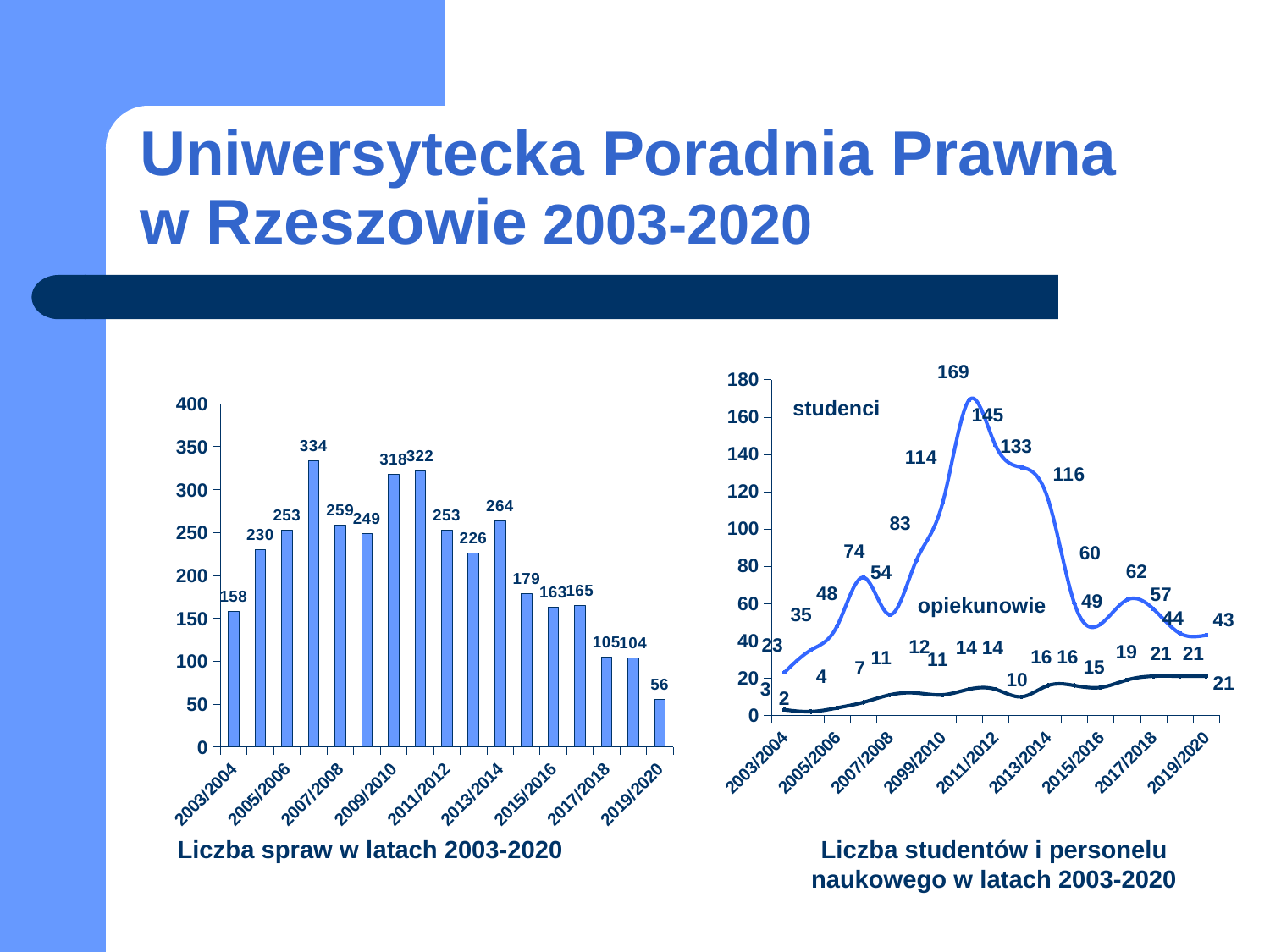
In the chart 'Liczba spraw w latach 2003-2020', which is larger: the value for 2009/2010 or the value for 2011/2012? 2009/2010 In the chart 'Liczba spraw w latach 2003-2020', what is the value for 2019/2020? 56 What kind of chart is 'Liczba studentów i personelu naukowego w latach 2003-2020'? line chart In the chart 'Liczba spraw w latach 2003-2020', which year has the lowest value? 2019/2020 In the chart 'Liczba spraw w latach 2003-2020', what is the value for 2003/2004? 158 How many series are plotted in the chart 'Liczba studentów i personelu naukowego w latach 2003-2020'? 2 What kind of chart is 'Liczba spraw w latach 2003-2020'? bar chart In the chart 'Liczba spraw w latach 2003-2020', do the values rise or fall from 2013/2014 to 2019/2020? fall In the chart 'Liczba studentów i personelu naukowego w latach 2003-2020', what is the highest value of the 'studenci' series? 169 In the chart 'Liczba spraw w latach 2003-2020', what is the difference between the highest value (334) and the value for 2003/2004 (158)? 176 In the chart 'Liczba spraw w latach 2003-2020', which year has the highest value? 2006/2007 In the chart 'Liczba studentów i personelu naukowego w latach 2003-2020', what is the value of 'studenci' for 2019/2020? 43